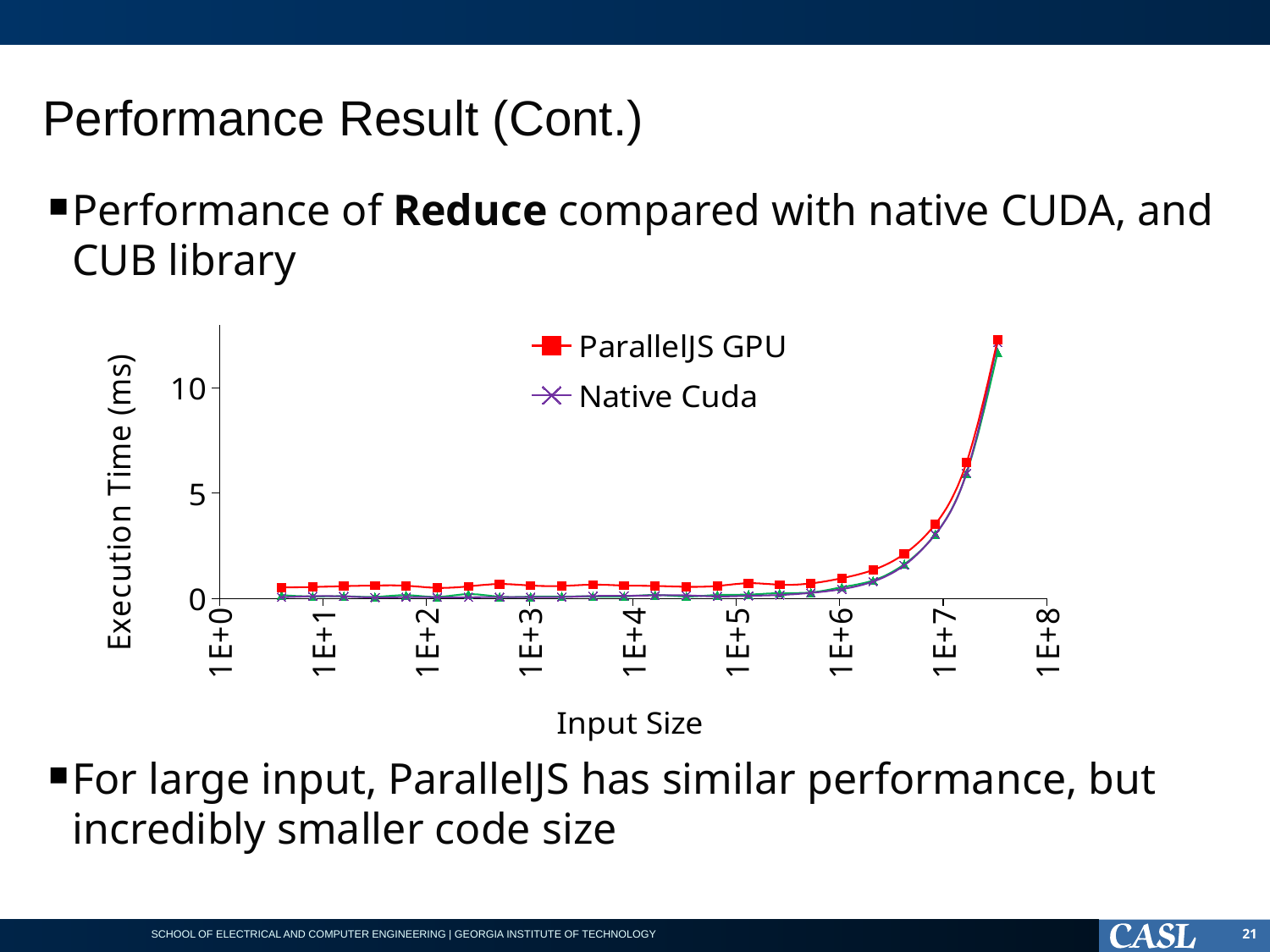
Is the ParallelJS GPU execution time at input size 1E+3 greater or less than 5? less What are the two series named in the chart's legend? ParallelJS GPU and Native Cuda Is the Native Cuda execution time at input size 1E+7 greater or less than 10? less Does the execution time rise or fall as input size increases along the x-axis? rise Is the ParallelJS GPU execution time at the largest input size greater or less than 10? greater How many series does the chart's legend list? 2 For small input sizes (around 1E+1 to 1E+5), which series has the higher execution time, ParallelJS GPU or Native Cuda? ParallelJS GPU Which series is drawn with red square markers? ParallelJS GPU What kind of chart is shown on the slide? line chart What is the label of the chart's y-axis? Execution Time (ms)